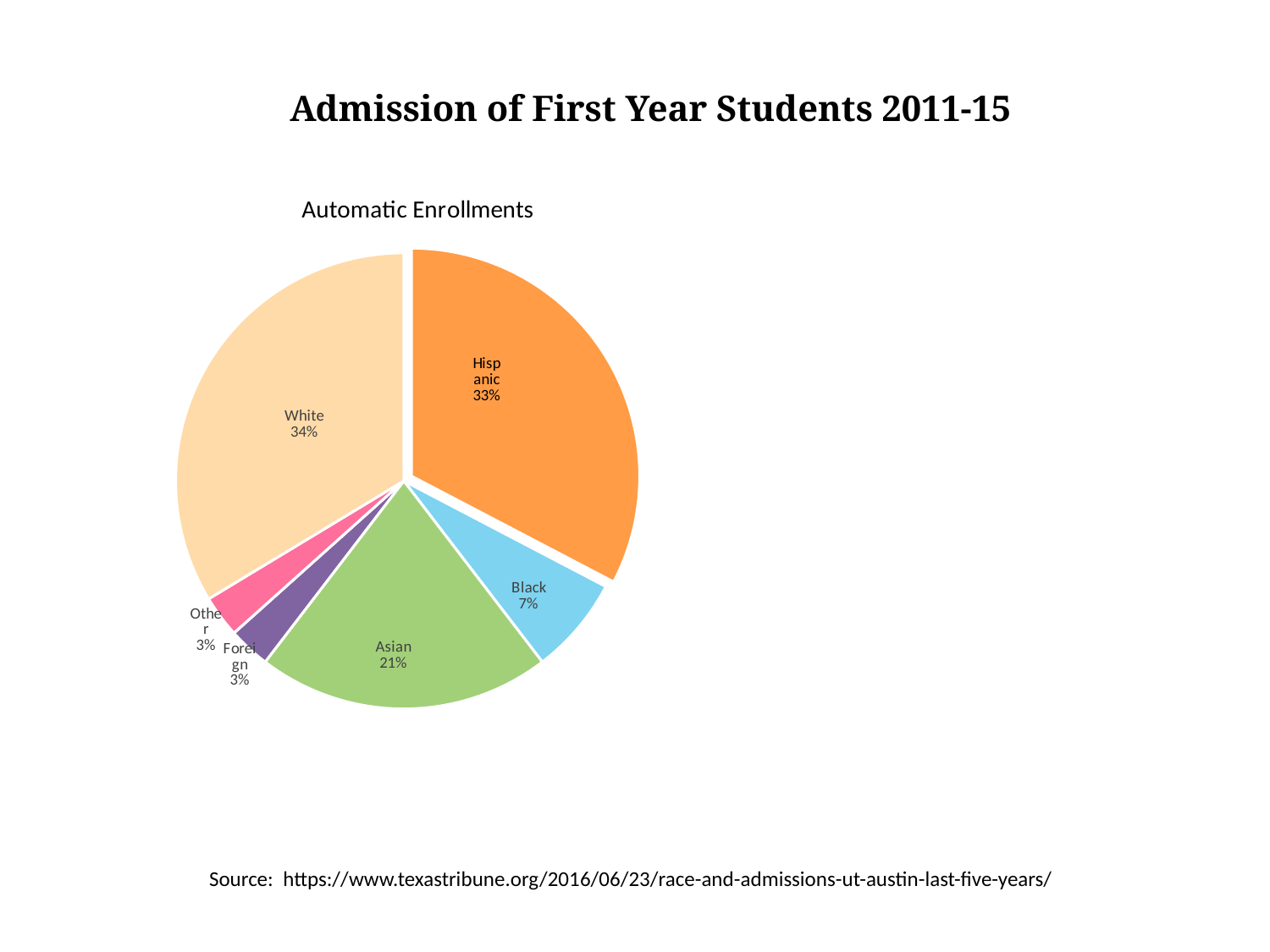
Which category has the largest slice of the pie? White What is the title of the chart? Automatic Enrollments What percentage is shown for the Hispanic slice? 33% What share of the pie does the White slice represent? 34% What percentage is shown for the Asian slice? 21% How many slices does the pie chart have? 6 Which slice is larger, Hispanic or Asian? Hispanic What is the difference in percentage points between the Asian and Black slices? 14 What percentage is shown for the Black slice? 7% Which slice is larger, Asian or Black? Asian What percentage is shown for the Foreign slice? 3% What type of chart is shown on the slide? Pie chart